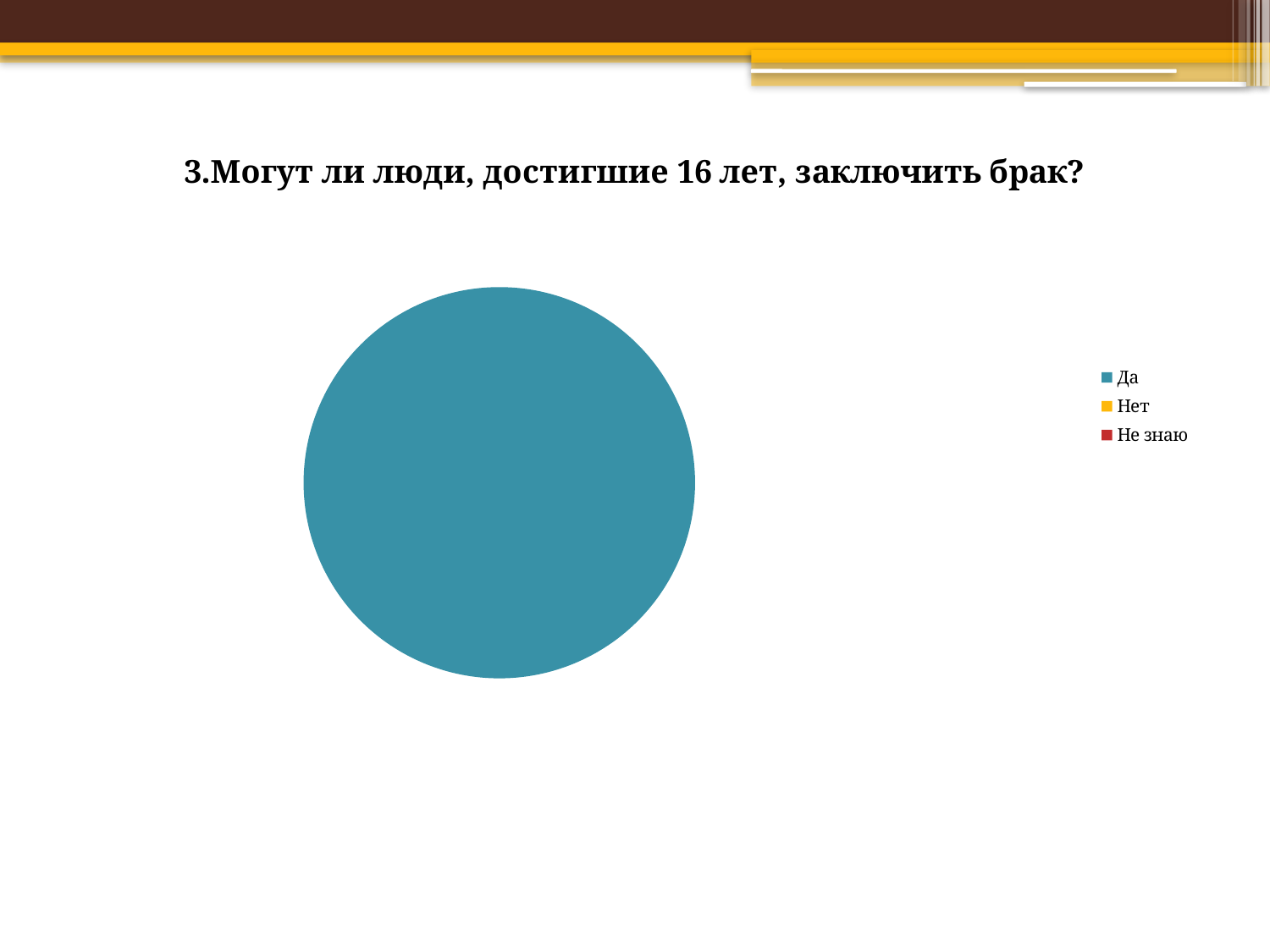
Which legend entry is shown in blue? Да Which category takes up the largest share of the pie chart? Да Which is larger in the pie chart, the share for Да or the share for Не знаю? Да What kind of chart is shown on the slide? pie chart Which is larger in the pie chart, the share for Да or the share for Нет? Да What is the title of the chart on the slide? 3.Могут ли люди, достигшие 16 лет, заключить брак? How many entries does the legend of the pie chart list? 3